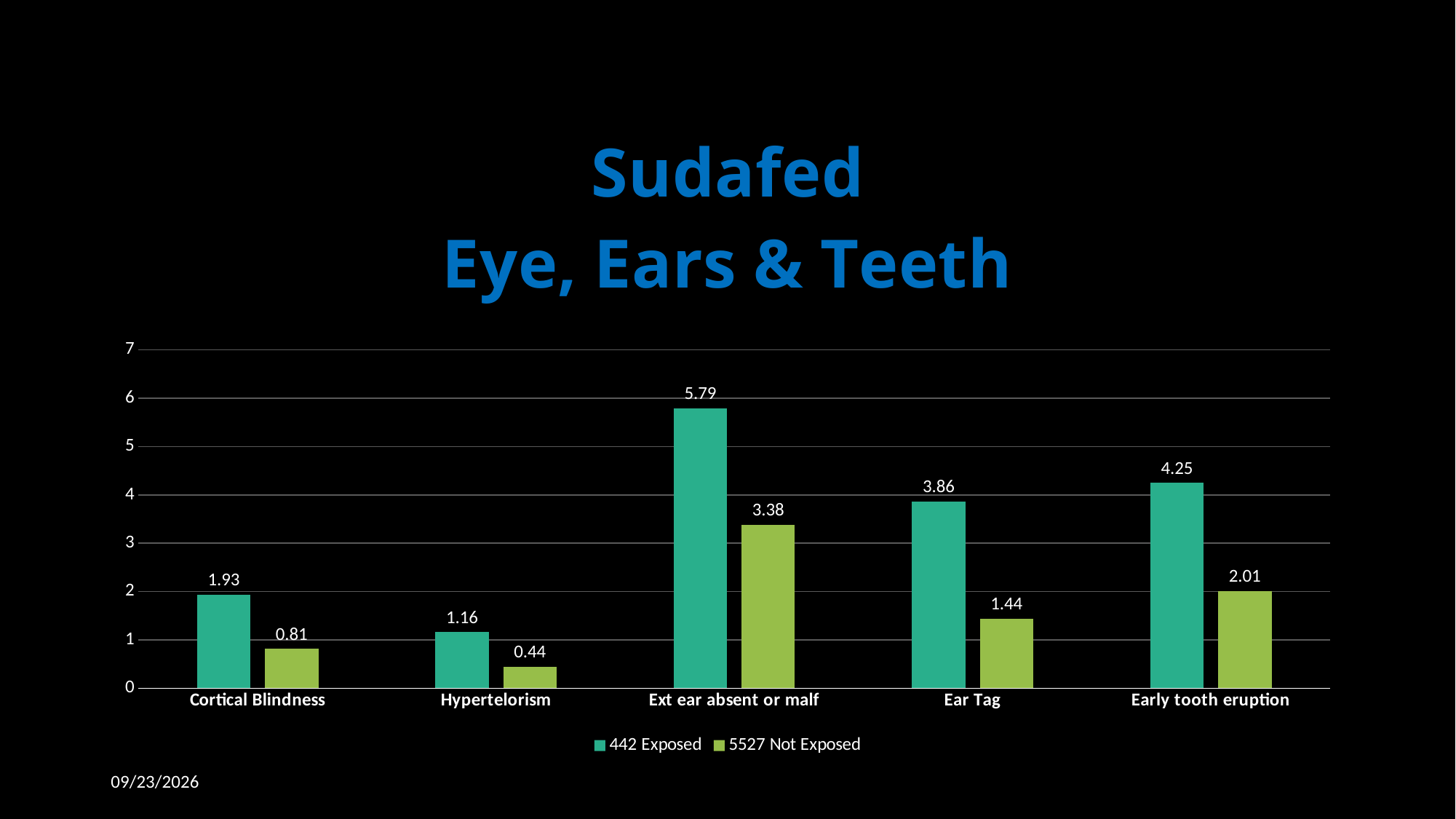
What is the value for Early tooth eruption in the 5527 Not Exposed series? 2.01 How many categories are shown on the x axis? 5 What is the value for Ext ear absent or malf in the 442 Exposed series? 5.79 Which category has the lowest value in the 5527 Not Exposed series? Hypertelorism What is the value for Hypertelorism in the 5527 Not Exposed series? 0.44 Which is larger for Cortical Blindness: the 442 Exposed value or the 5527 Not Exposed value? 442 Exposed Which category has the highest value in the 442 Exposed series? Ext ear absent or malf What is the difference between the 442 Exposed and 5527 Not Exposed values for Ear Tag? 2.42 How many series does the legend list? 2 What is the title of the slide? Sudafed Eye, Ears & Teeth Is the 442 Exposed value for Early tooth eruption greater or less than 4? greater What kind of chart is shown on the slide? Bar chart